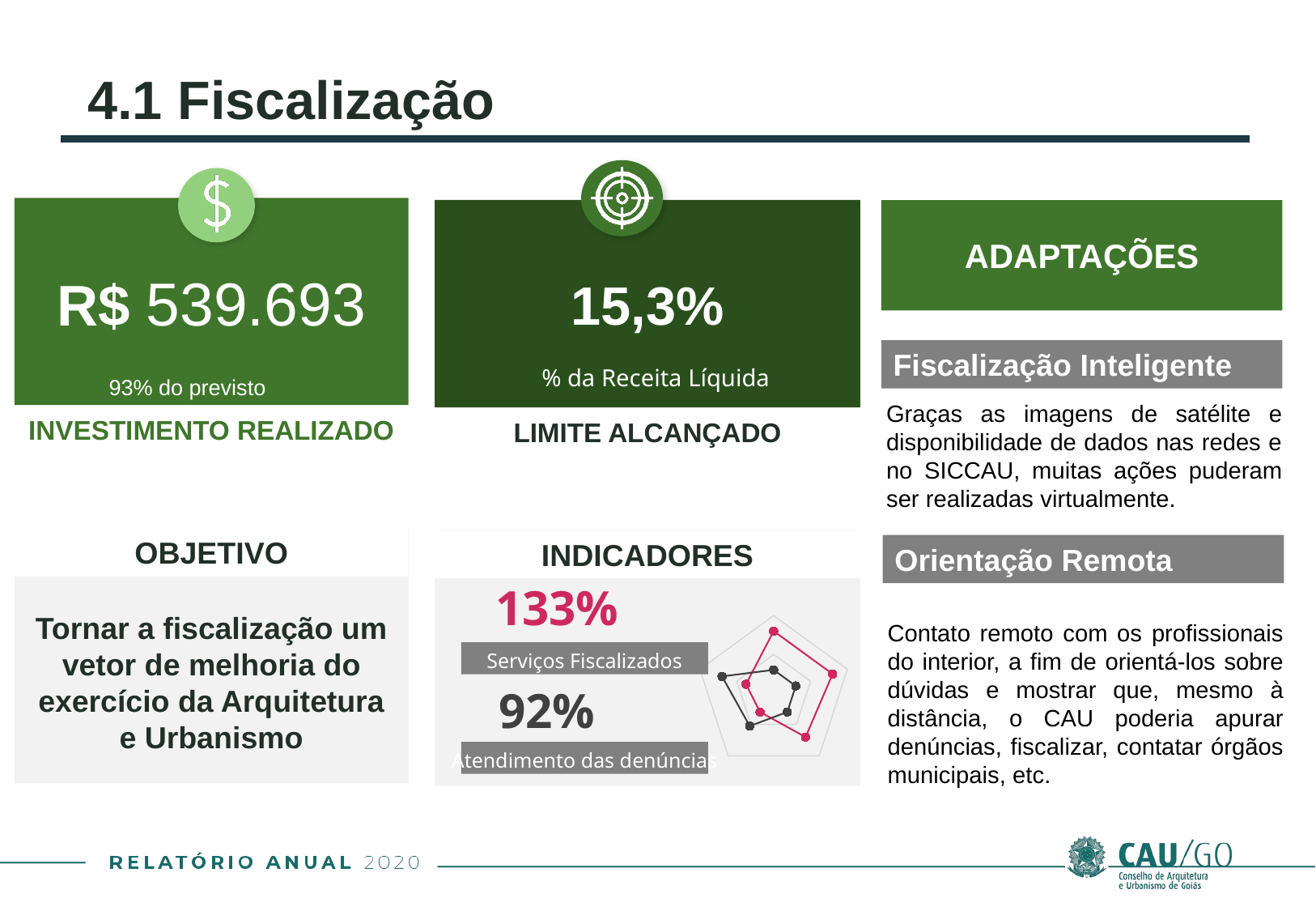
How many data series are plotted on the radar chart in the INDICADORES panel? 2 Does the radar chart in the INDICADORES panel show a legend? No In the INDICADORES panel, what value is printed for Atendimento das denúncias? 92% In the INDICADORES panel, which indicator has the higher printed value, Serviços Fiscalizados or Atendimento das denúncias? Serviços Fiscalizados How many axes (vertices) does the radar chart in the INDICADORES panel have? 5 What kind of chart is shown in the INDICADORES panel? radar chart In the INDICADORES panel, what is the difference between the Serviços Fiscalizados value and the Atendimento das denúncias value? 41% In the INDICADORES panel, what value is printed for Serviços Fiscalizados? 133% What two colours are used for the series on the radar chart in the INDICADORES panel? red and dark gray